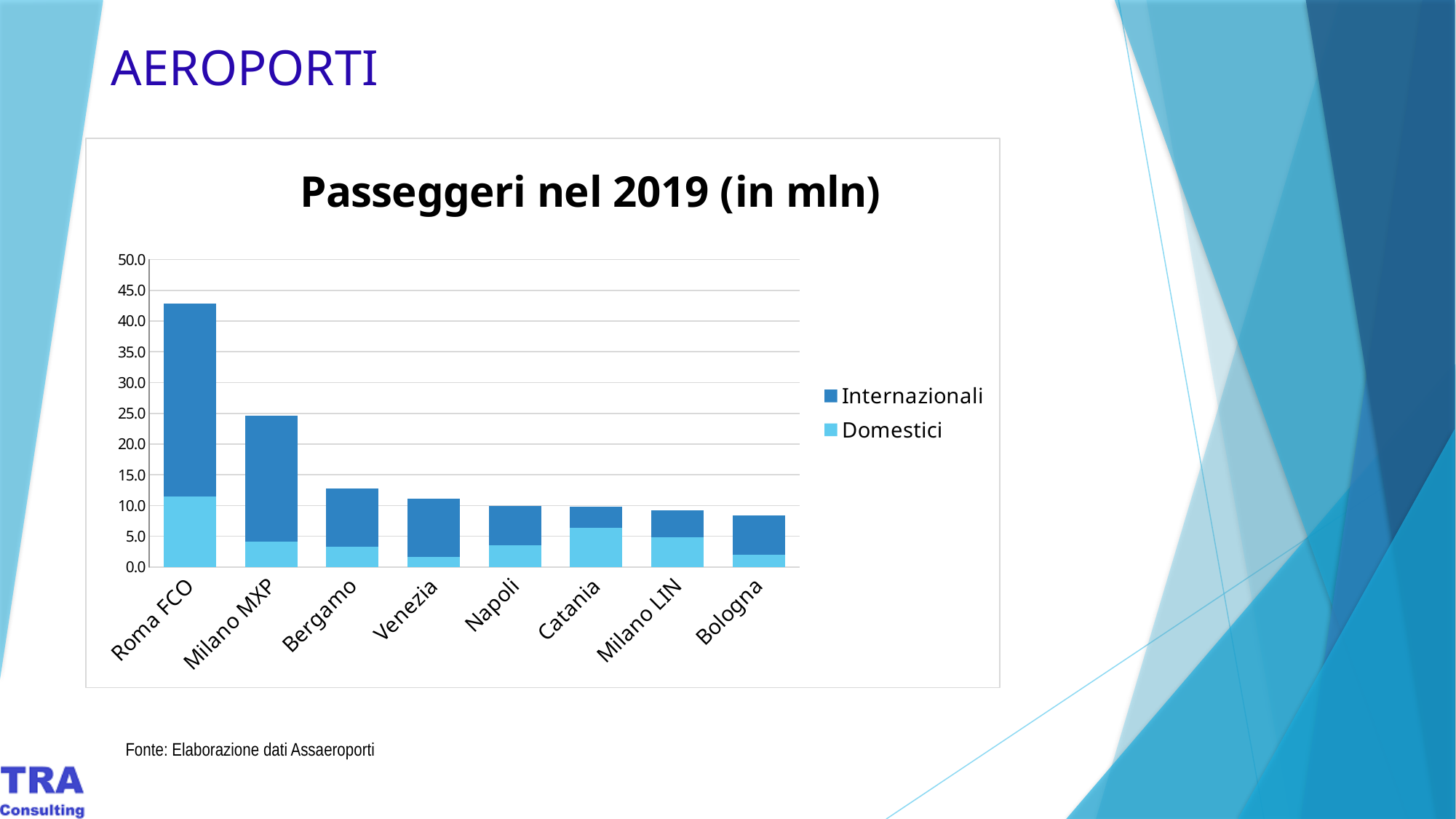
Which airport has the highest total number of passengers? Roma FCO Do the total bar heights rise or fall from left to right along the x axis? fall Which two series are listed in the legend? Internazionali and Domestici Is the total value for Bergamo greater or less than 15.0? less What kind of chart is shown on the slide? Stacked bar chart How many airports are shown on the x axis of the chart? 8 Which has the larger Domestici value, Catania or Napoli? Catania Is the total value for Milano MXP greater or less than 20.0? greater Is the total value for Roma FCO greater or less than 40.0? greater What is the title of the chart? Passeggeri nel 2019 (in mln) Which airport has the lowest total number of passengers? Bologna How many series does the legend list? 2